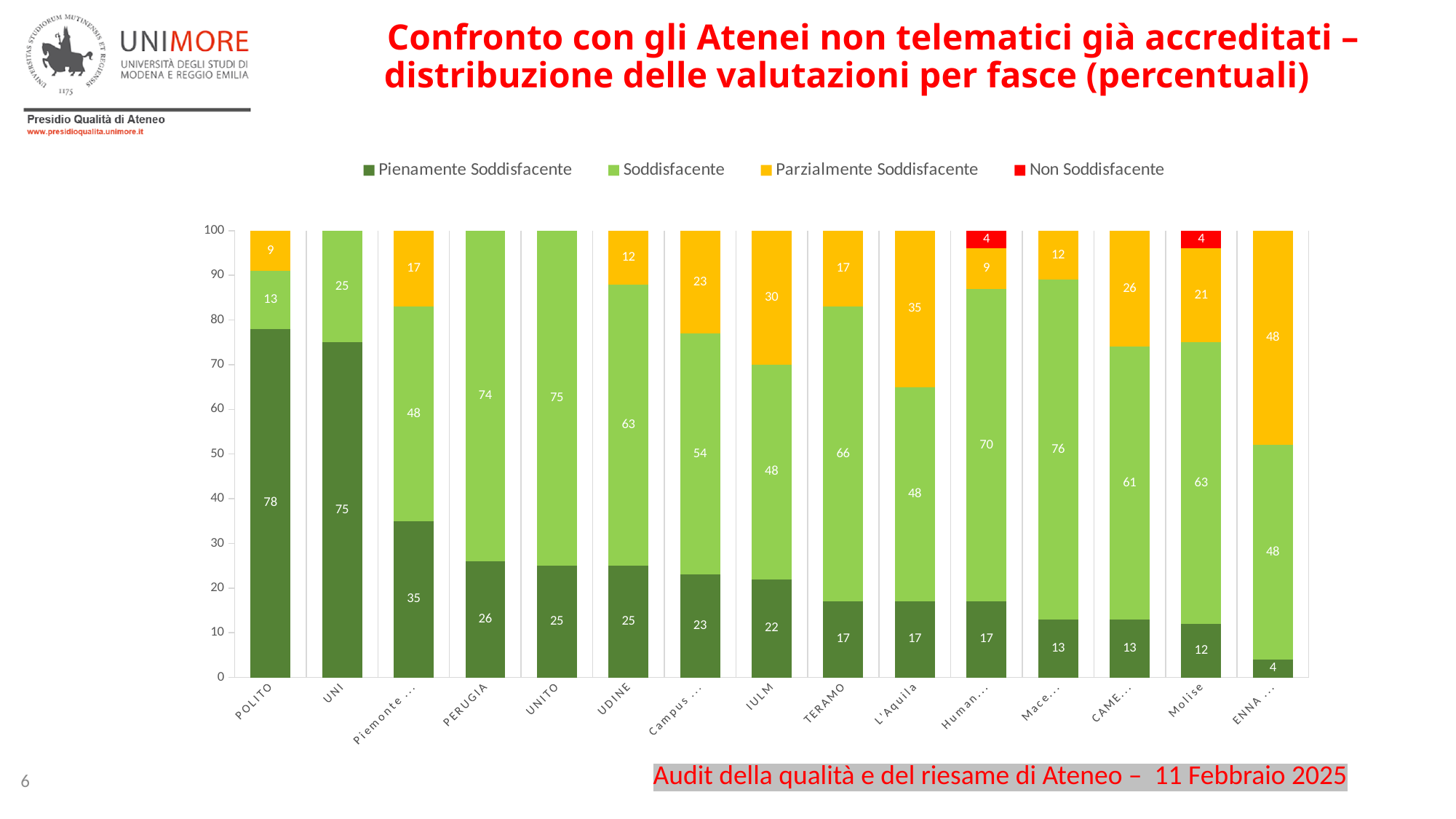
What is the Soddisfacente value for UNITO? 75 What is the difference between the Pienamente Soddisfacente values for POLITO and UNI? 3 Which category has the highest Pienamente Soddisfacente value? POLITO Which category has the lowest Pienamente Soddisfacente value? ENNA Which is larger, the Parzialmente Soddisfacente value for L'Aquila or for TERAMO? L'Aquila How many categories are shown on the x axis? 15 How many series does the legend list? 4 What is the Parzialmente Soddisfacente value for IULM? 30 Which colour represents the Non Soddisfacente series? Red What kind of chart is shown on the slide? Stacked bar chart What is the Non Soddisfacente value for Molise? 4 What is the Pienamente Soddisfacente value for POLITO? 78